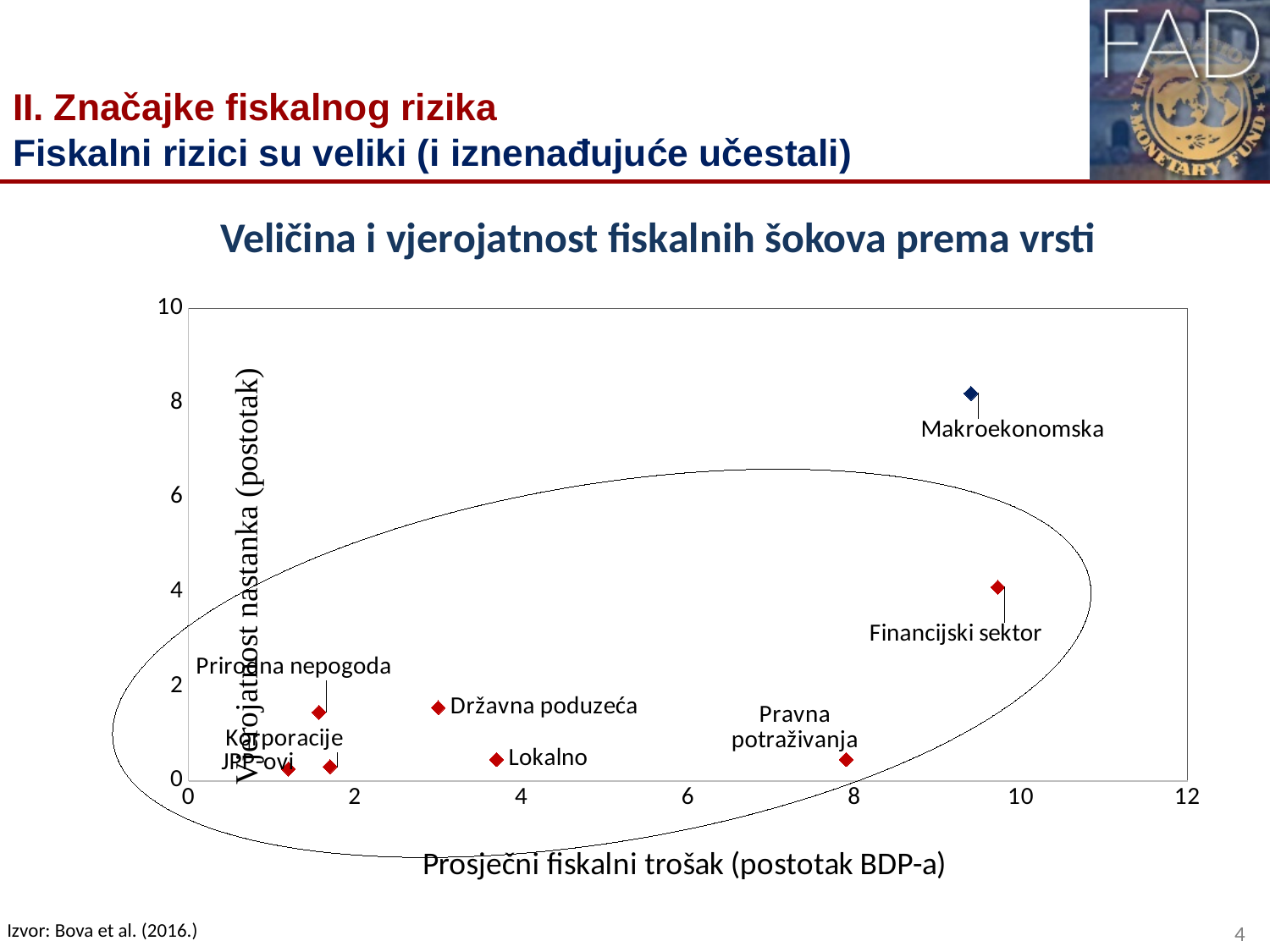
Which has the higher vertical-axis value, Makroekonomska or Financijski sektor? Makroekonomska Which data point has the highest value on the vertical axis (Vjerojatnost nastanka)? Makroekonomska Is the horizontal-axis value for Financijski sektor greater or less than 8? greater How many labelled data points are plotted on the chart? 8 Is the horizontal-axis value for Državna poduzeća greater or less than 4? less What is the label of the x axis of the chart? Prosječni fiskalni trošak (postotak BDP-a) Is the vertical-axis value for Pravna potraživanja greater or less than 2? less What kind of chart is shown on the slide? Scatter chart What is the title of the chart? Veličina i vjerojatnost fiskalnih šokova prema vrsti Which data point has the lowest value on the horizontal axis (Prosječni fiskalni trošak)? JPP-ovi Which has the higher horizontal-axis value, Pravna potraživanja or Državna poduzeća? Pravna potraživanja